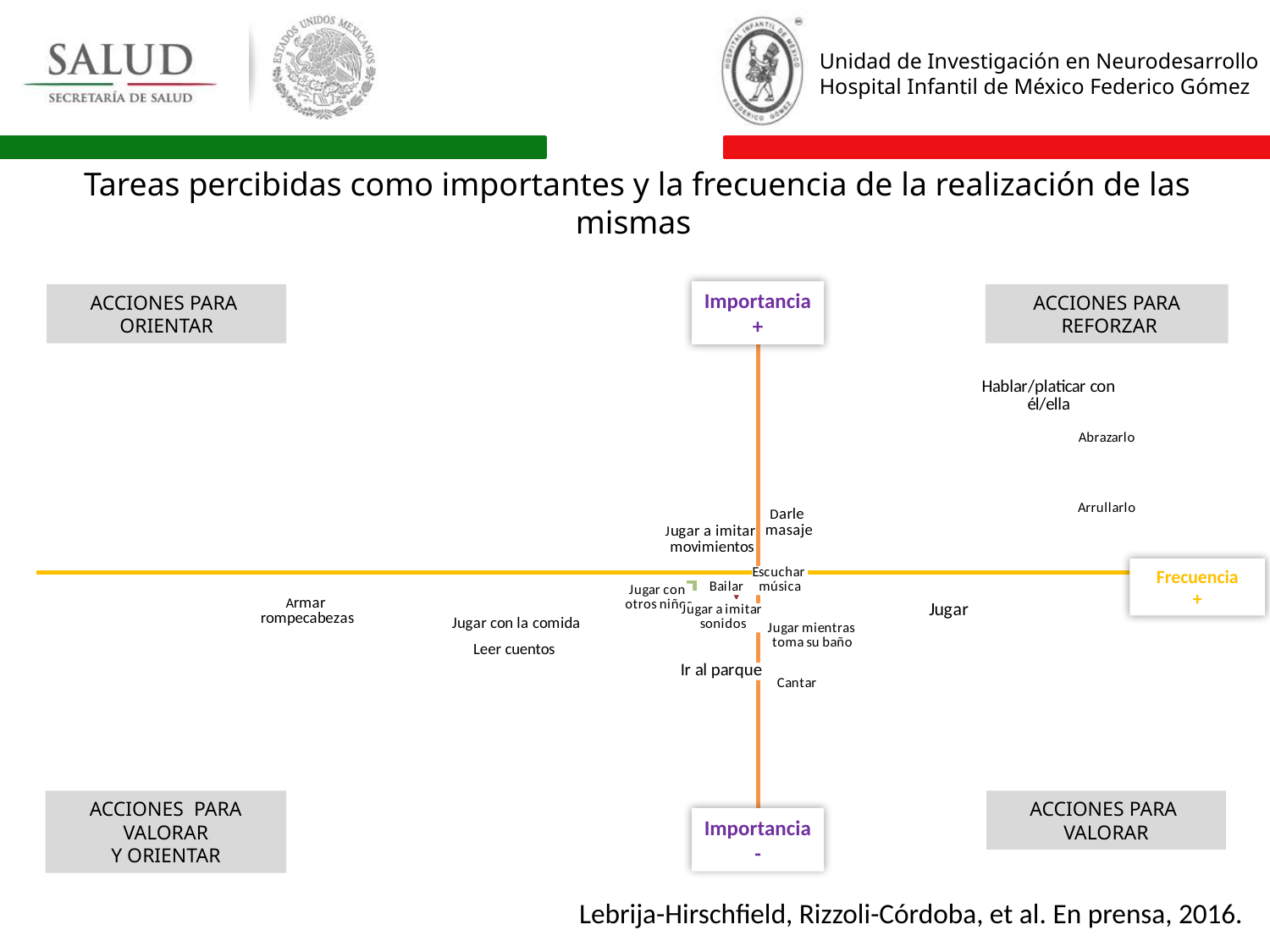
In which quadrant of the chart is Hablar/platicar con él/ella plotted? ACCIONES PARA REFORZAR (top right) What source is cited below the chart? Lebrija-Hirschfield, Rizzoli-Córdoba, et al. En prensa, 2016. What kind of chart is shown on the slide? scatter chart Which is plotted further to the right on the Frecuencia axis, Jugar or Leer cuentos? Jugar How many tasks are plotted as labeled points on the chart? 16 Which task is plotted in the top-left quadrant labeled ACCIONES PARA ORIENTAR? Jugar a imitar movimientos In which quadrant of the chart is Jugar plotted? ACCIONES PARA VALORAR (bottom right) In which quadrant of the chart is Armar rompecabezas plotted? ACCIONES PARA VALORAR Y ORIENTAR (bottom left) What is the title of the chart on the slide? Tareas percibidas como importantes y la frecuencia de la realización de las mismas Which task is plotted furthest to the left on the Frecuencia axis? Armar rompecabezas Which is plotted higher on the Importancia axis, Abrazarlo or Arrullarlo? Abrazarlo Which task is plotted highest on the Importancia axis? Hablar/platicar con él/ella